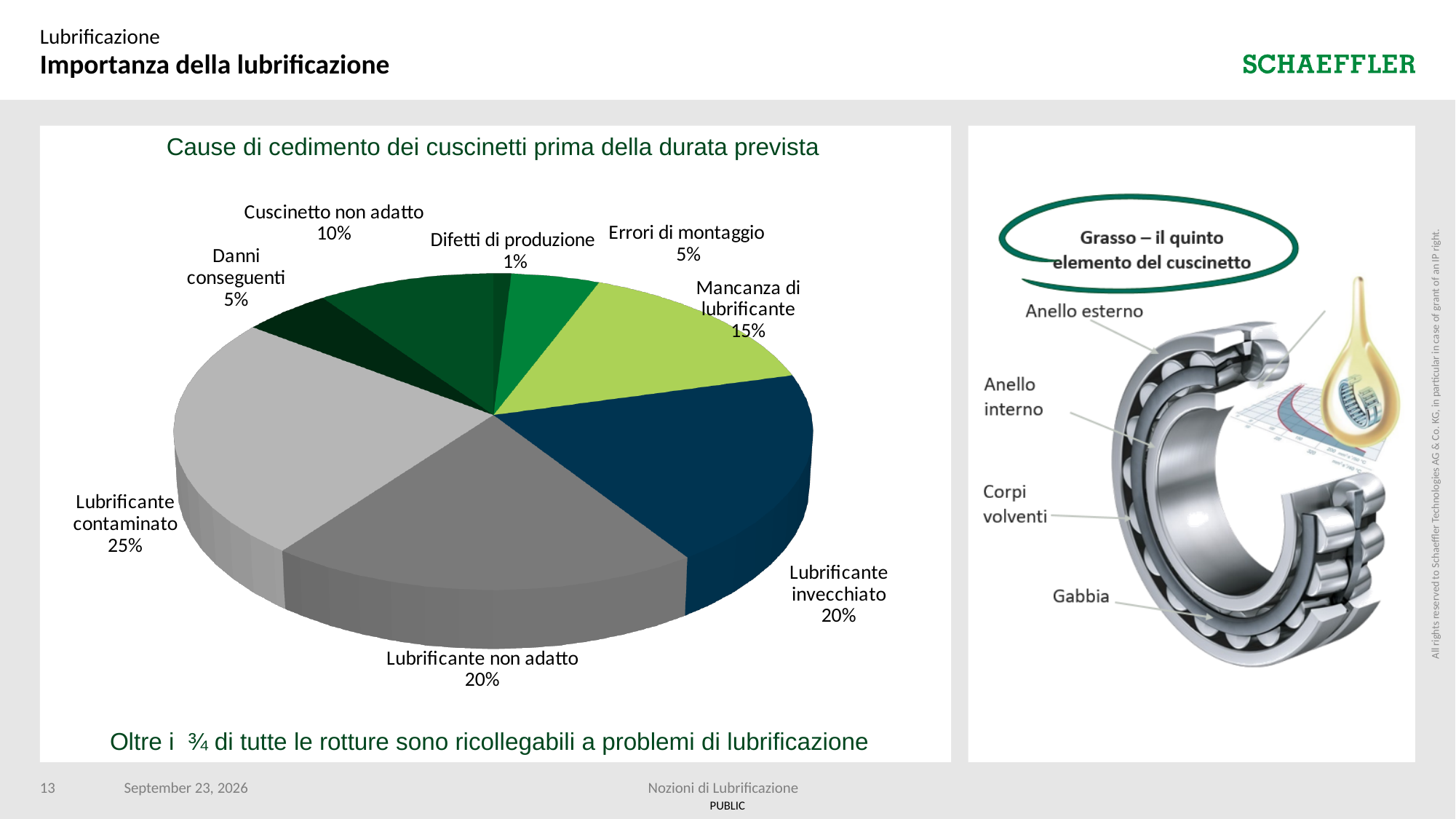
Which cause has the largest share of the pie? Lubrificante contaminato What percentage is shown for Lubrificante contaminato? 25% What percentage is shown for Cuscinetto non adatto? 10% What is the difference between the shares of Lubrificante contaminato and Lubrificante invecchiato? 5% What is the title of the pie chart? Cause di cedimento dei cuscinetti prima della durata prevista What share of the pie does Lubrificante non adatto represent? 20% Which cause has the smallest share of the pie? Difetti di produzione What percentage is shown for Difetti di produzione? 1% Which is larger, the share for Mancanza di lubrificante or the share for Errori di montaggio? Mancanza di lubrificante How many slices does the pie chart have? 8 What kind of chart is shown on the slide? Pie chart What percentage is shown for Mancanza di lubrificante? 15%